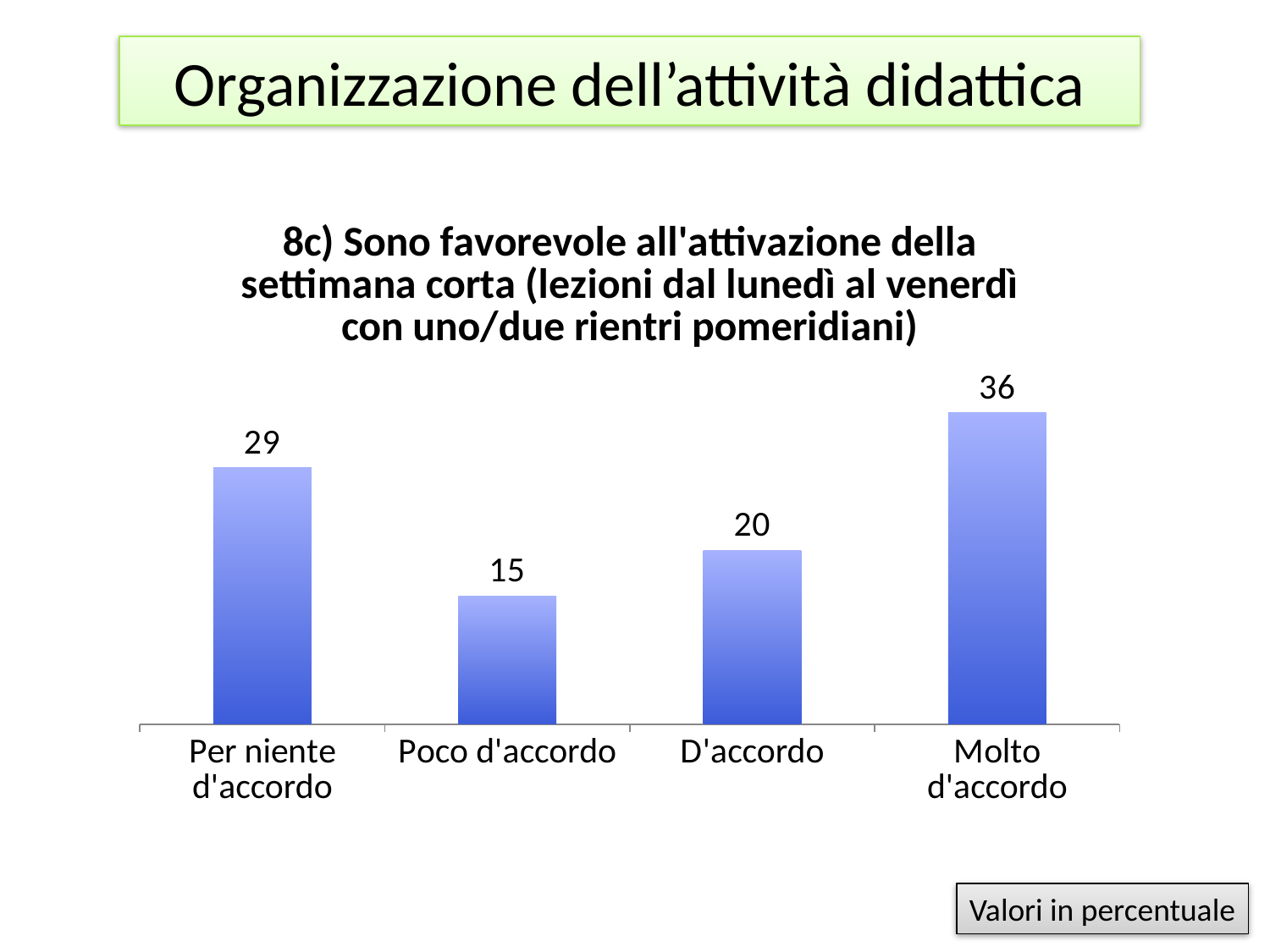
What is the value for "Per niente d'accordo"? 29 Which is larger, the value for "Per niente d'accordo" or the value for "D'accordo"? Per niente d'accordo What kind of chart is shown on the slide? Bar chart What is the value for "Molto d'accordo"? 36 What is the difference between the values for "D'accordo" and "Poco d'accordo"? 5 What is the difference between the values for "Molto d'accordo" and "Per niente d'accordo"? 7 How many categories are shown on the x axis? 4 What is the value for "Poco d'accordo"? 15 According to the note on the slide, in what unit are the values expressed? Percentuale (percentage) What is the value for "D'accordo"? 20 Which category has the highest value? Molto d'accordo Which category has the lowest value? Poco d'accordo